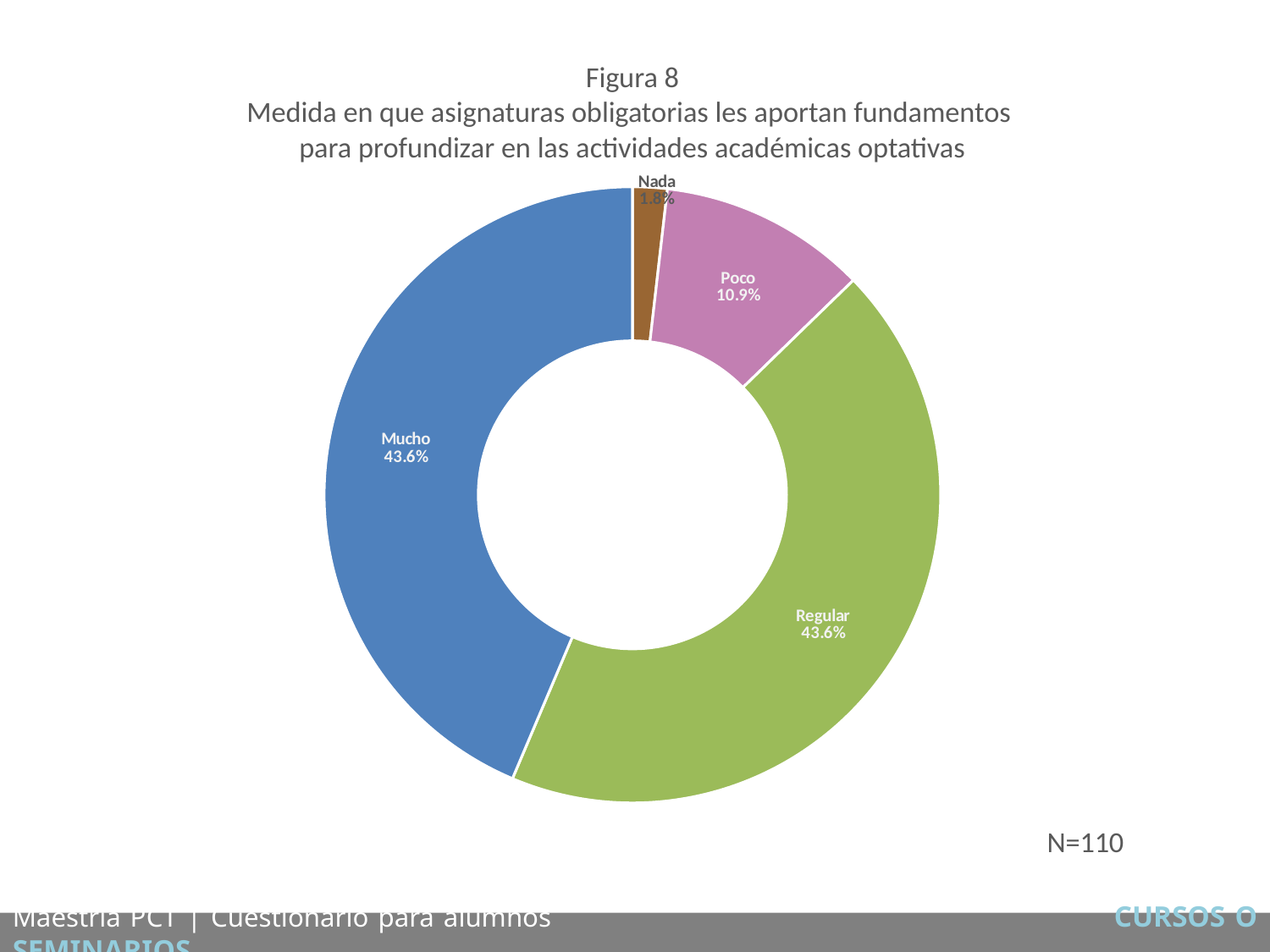
How many categories (slices) does the chart have? 4 What percentage is shown for the "Nada" slice? 1.8% What percentage is shown for the "Mucho" slice? 43.6% What kind of chart is shown on the slide? Doughnut (pie) chart What percentage is shown for the "Poco" slice? 10.9% Which slice is larger, "Mucho" or "Poco"? Mucho Which slice is larger, "Poco" or "Nada"? Poco By how many percentage points does "Poco" exceed "Nada"? 9.1 percentage points What percentage is shown for the "Regular" slice? 43.6% By how many percentage points does "Regular" exceed "Poco"? 32.7 percentage points What is the figure number given in the chart title? Figura 8 Which category has the smallest slice of the chart? Nada